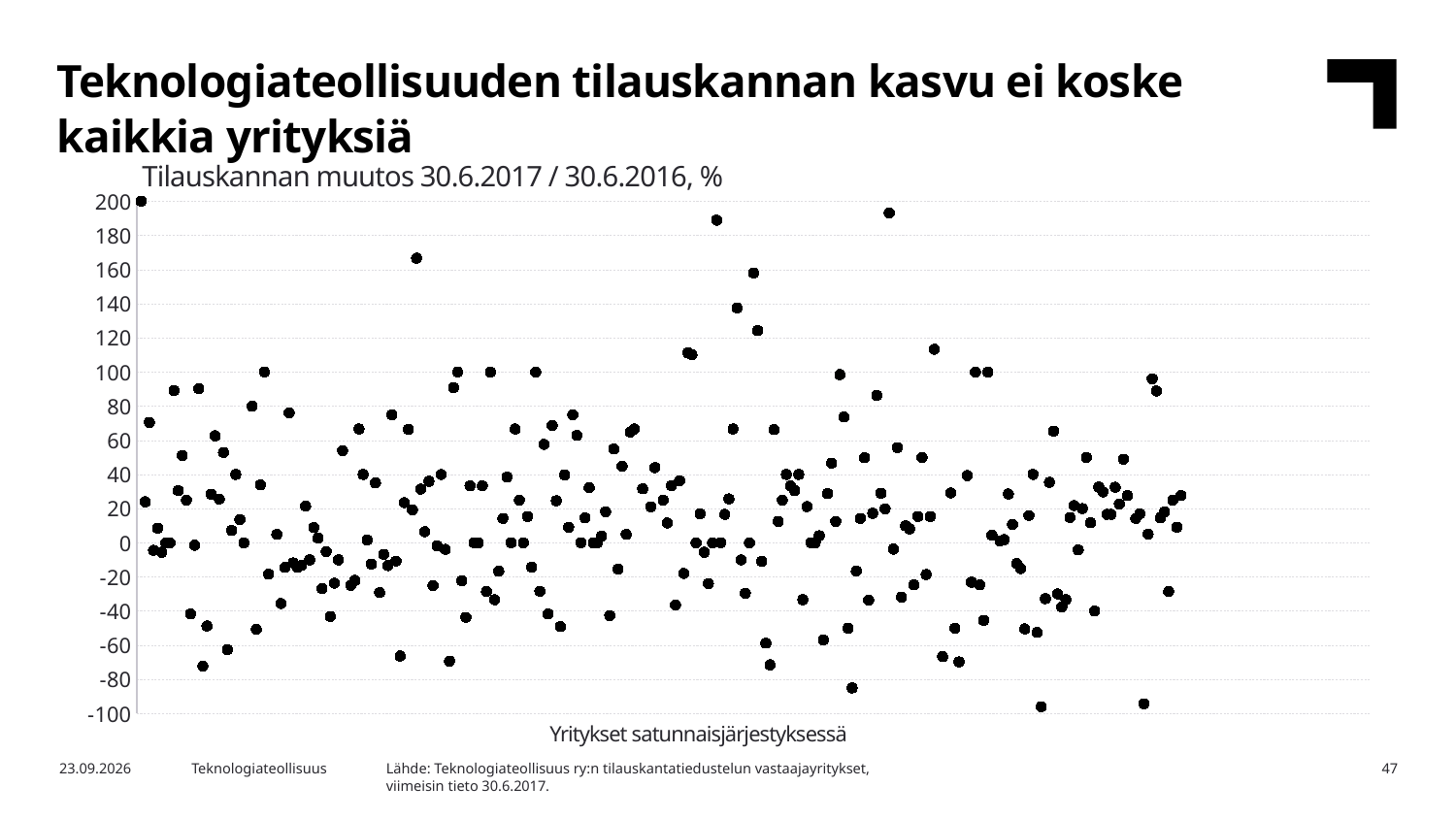
What is the title of the chart? Tilauskannan muutos 30.6.2017 / 30.6.2016, % What kind of chart is shown on the slide? Scatter chart What is the label of the x axis? Yritykset satunnaisjärjestyksessä What is the lowest value shown on the y axis? -100 What is the highest value shown on the y axis? 200 Are the plotted values mostly above or below 100? below Is the lowest plotted point greater or less than -80? less Is the highest plotted point greater or less than 180? greater